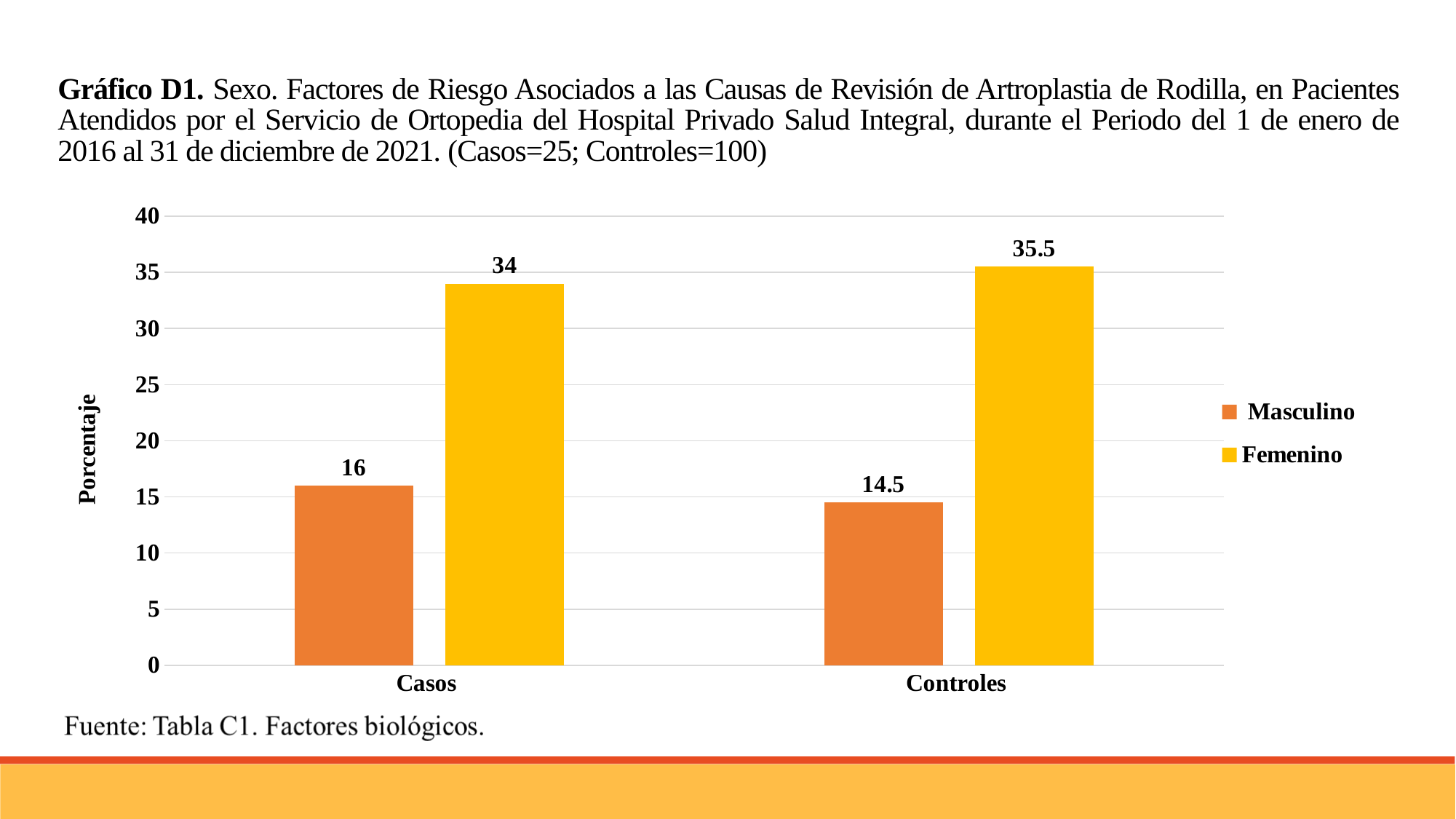
Which category has the lowest Masculino value? Controles How many series does the legend list? 2 What is the difference between the Femenino and Masculino values for Casos? 18 How many categories are shown on the x axis? 2 What is the Masculino value for Casos? 16 Which is larger, the Masculino value for Casos or the Masculino value for Controles? Casos What is the Femenino value for Casos? 34 Which category has the highest Femenino value? Controles What is the difference between the Femenino values for Controles and Casos? 1.5 What is the Masculino value for Controles? 14.5 What kind of chart is shown on the slide? Bar chart What is the Femenino value for Controles? 35.5